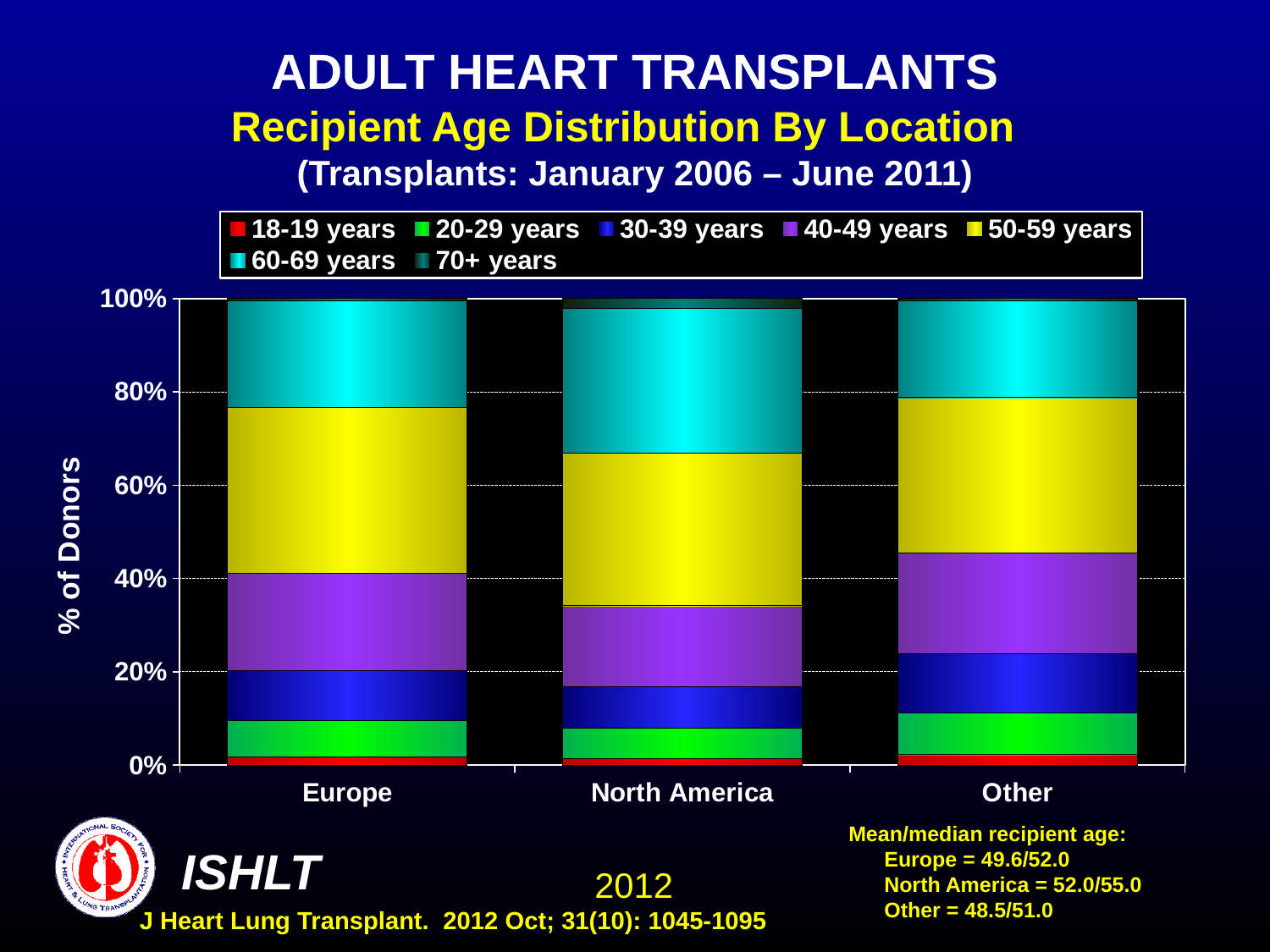
Is the 50-59 years segment larger for Europe or for Other? Europe According to the note on the slide, what is the mean/median recipient age for North America? 52.0/55.0 How many locations are shown on the x axis of the chart? 3 Is the 60-69 years segment larger for North America or for Other? North America How many age-group series does the legend list? 7 Which location has the largest 60-69 years segment? North America What kind of chart is shown on the slide? Stacked bar chart Is the 40-49 years segment larger for Europe or for North America? Europe Is the cumulative top of the 40-49 years segment for North America greater or less than 40%? less What is the label on the y axis of the chart? % of Donors Is the cumulative top of the 50-59 years segment for Europe greater or less than 60%? greater